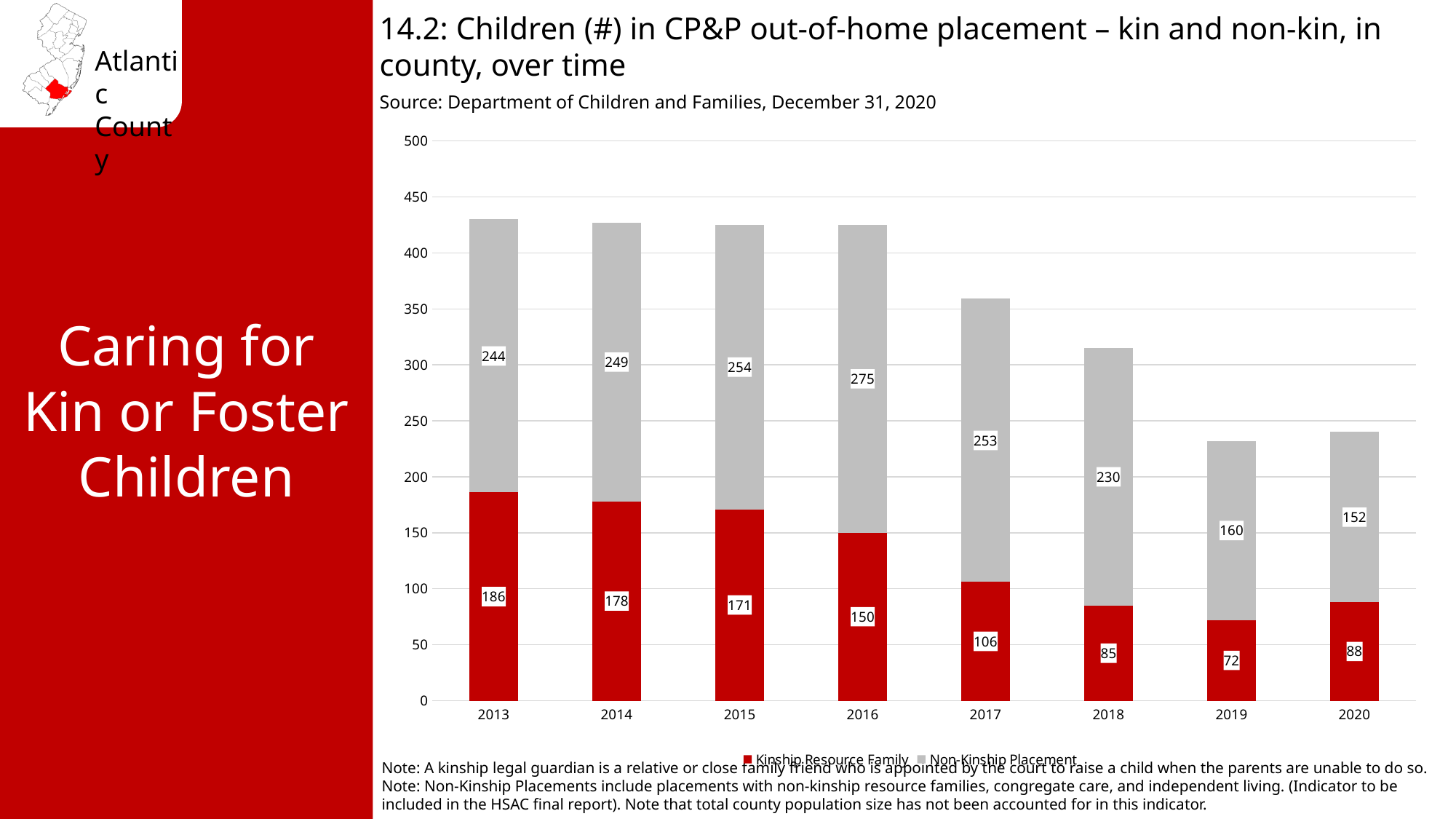
How many series does the chart's legend list? 2 What is the difference between the Non-Kinship Placement value and the Kinship Resource Family value in 2017? 147 Does the Kinship Resource Family value generally rise or fall from 2013 to 2019? fall How many years are shown on the x axis of the chart? 8 What is the Non-Kinship Placement value for 2018? 230 What is the total number of children in out-of-home placement in 2020 (sum of both series)? 240 In which year is the Non-Kinship Placement value highest? 2016 What type of chart is shown on the slide? Stacked bar chart In which year is the Kinship Resource Family value lowest? 2019 Which is larger in 2013: the Kinship Resource Family value or the Non-Kinship Placement value? Non-Kinship Placement What is the Kinship Resource Family value for 2016? 150 Is the total height of the 2019 stacked bar greater or less than 250? less